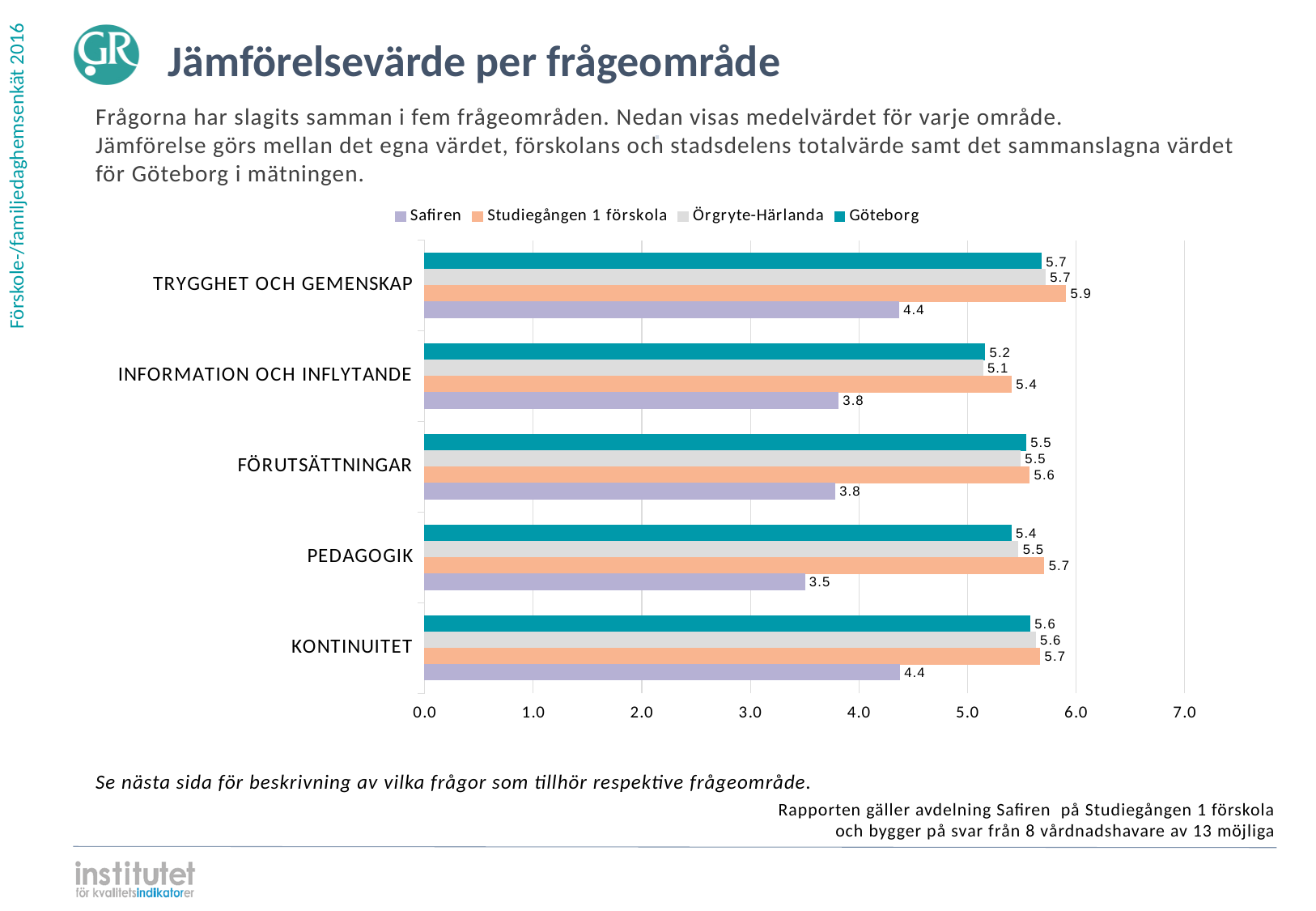
What is the value for Örgryte-Härlanda in the KONTINUITET category? 5.6 Which series is shown in teal (dark green) on the chart? Göteborg What is the value for Studiegången 1 förskola in the TRYGGHET OCH GEMENSKAP category? 5.9 In which category does Safiren have its lowest value? PEDAGOGIK How many categories (frågeområden) are shown on the chart? 5 What is the value for Göteborg in the INFORMATION OCH INFLYTANDE category? 5.2 What is the difference between the Studiegången 1 förskola value and the Safiren value in the FÖRUTSÄTTNINGAR category? 1.8 What kind of chart is shown on the slide? Bar chart How many series does the legend list? 4 What is the value for Safiren in the PEDAGOGIK category? 3.5 In which category does Studiegången 1 förskola have its highest value? TRYGGHET OCH GEMENSKAP Which is larger in the INFORMATION OCH INFLYTANDE category: the value for Göteborg or the value for Safiren? Göteborg